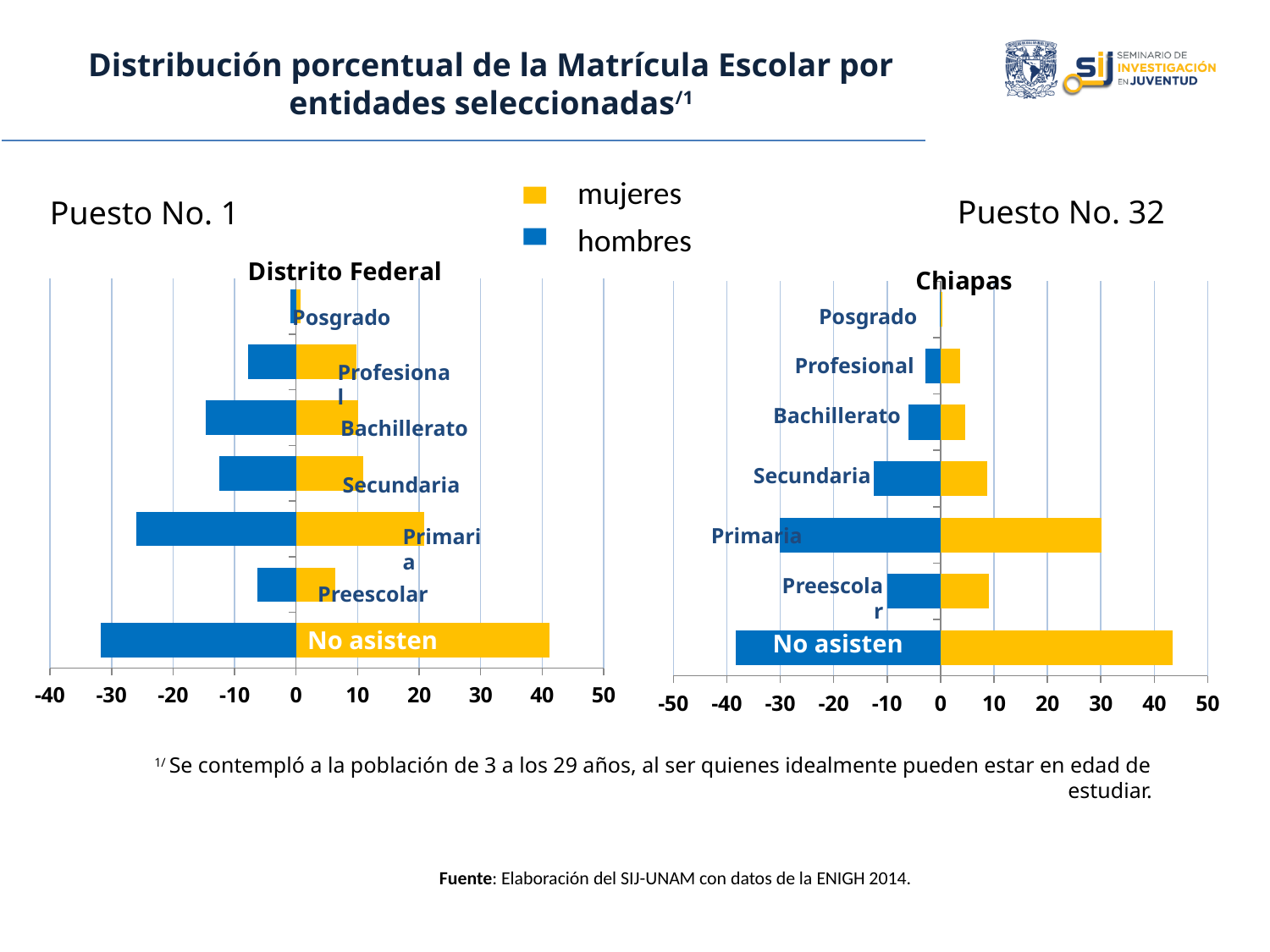
In the Distrito Federal chart, which category has the highest value for mujeres? No asisten In the Distrito Federal chart, is the mujeres value for Secundaria greater or less than 20? less In the Chiapas chart, is the mujeres value for Primaria greater or less than 20? greater How many series does the legend list? 2 In the Distrito Federal chart, is the mujeres value for No asisten greater or less than 30? greater What kind of chart is the Distrito Federal chart? bar chart In the Chiapas chart, which category has the lowest value for mujeres? Posgrado In the Distrito Federal chart, which is larger for mujeres: Profesional or Preescolar? Profesional Which colour represents mujeres in the legend? yellow In the Chiapas chart, which is larger for mujeres: Primaria or Secundaria? Primaria How many education categories are shown on the Chiapas chart? 7